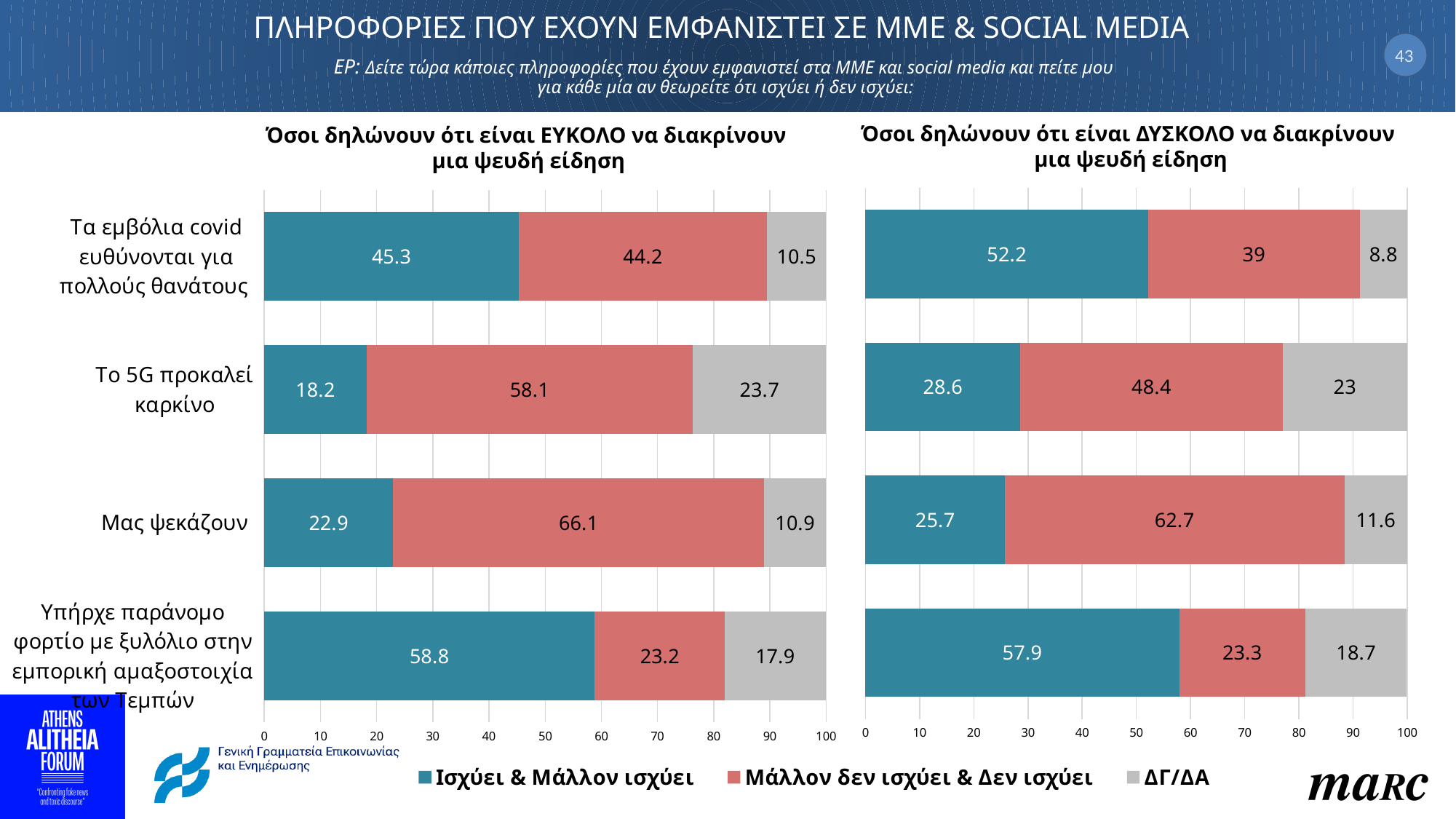
In the right chart (ΔΥΣΚΟΛΟ), what is the total of the stacked bar for 'Μας ψεκάζουν'? 100 Which colour represents 'ΔΓ/ΔΑ' in the legend? Grey Which is larger: the 'Ισχύει & Μάλλον ισχύει' value for 'Το 5G προκαλεί καρκίνο' in the left chart (ΕΥΚΟΛΟ) or in the right chart (ΔΥΣΚΟΛΟ)? Right chart (ΔΥΣΚΟΛΟ), 28.6 What type of chart is used on this slide? Stacked bar chart In the right chart (ΔΥΣΚΟΛΟ), what is the value of 'ΔΓ/ΔΑ' for 'Το 5G προκαλεί καρκίνο'? 23 How many series does the legend list? 3 In the right chart (ΔΥΣΚΟΛΟ), which category has the lowest 'Ισχύει & Μάλλον ισχύει' value? Μας ψεκάζουν In the left chart (ΕΥΚΟΛΟ), is the 'Ισχύει & Μάλλον ισχύει' value for 'Υπήρχε παράνομο φορτίο με ξυλόλιο στην εμπορική αμαξοστοιχία των Τεμπών' greater or less than 50? greater How many categories are shown in the left chart (ΕΥΚΟΛΟ)? 4 In the left chart (ΕΥΚΟΛΟ), which category has the highest 'Μάλλον δεν ισχύει & Δεν ισχύει' value? Μας ψεκάζουν In the left chart (ΕΥΚΟΛΟ), what is the value of 'Ισχύει & Μάλλον ισχύει' for 'Τα εμβόλια covid ευθύνονται για πολλούς θανάτους'? 45.3 In the left chart (ΕΥΚΟΛΟ), what is the difference between the 'Μάλλον δεν ισχύει & Δεν ισχύει' values for 'Μας ψεκάζουν' and 'Το 5G προκαλεί καρκίνο'? 8